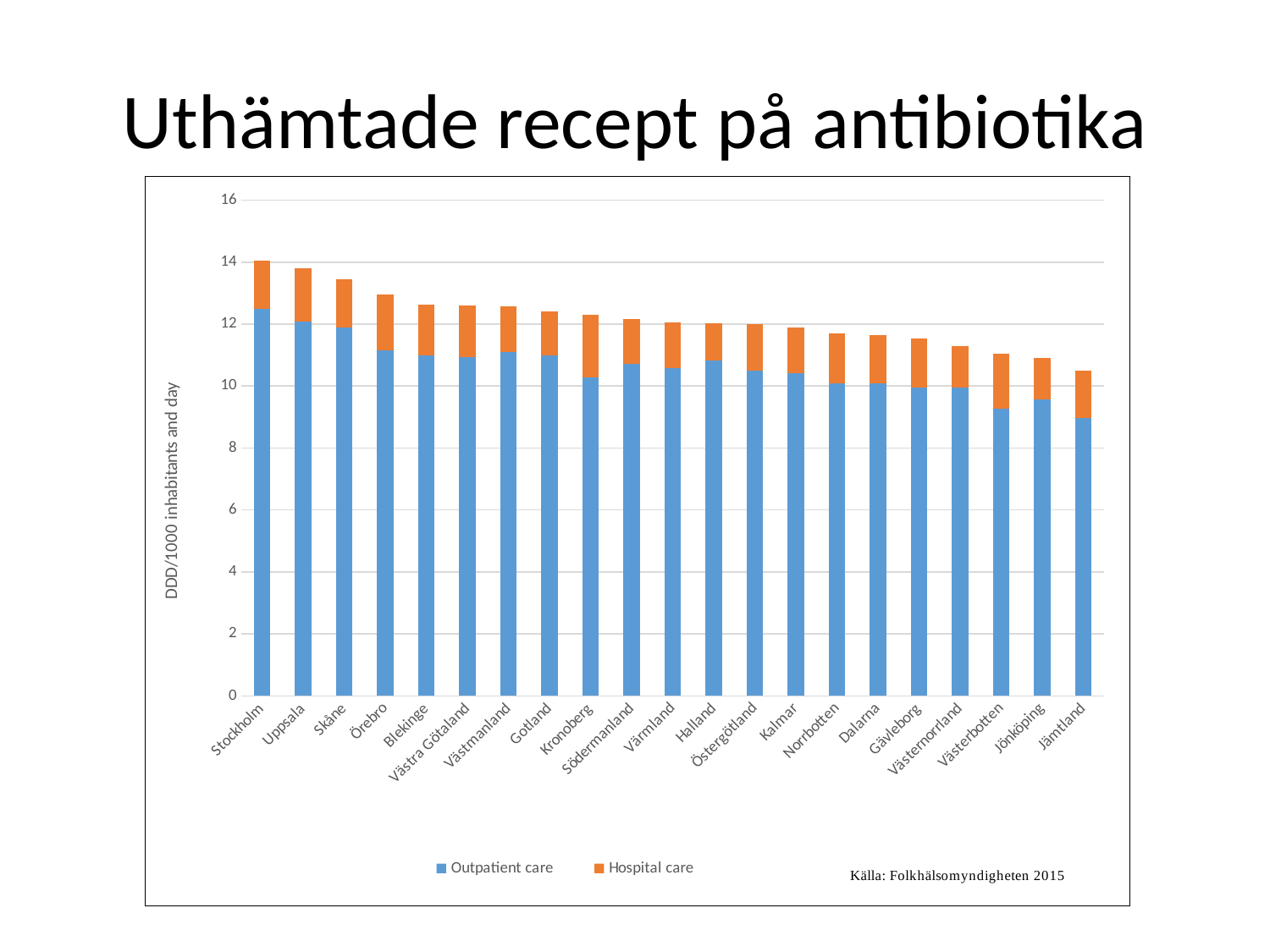
What kind of chart is shown on the slide? Stacked bar chart What is the label on the y axis of the chart? DDD/1000 inhabitants and day Which series is shown in orange in the chart? Hospital care Do the total bar heights rise or fall moving from left to right along the x axis? Fall Which region has the highest total bar in the chart? Stockholm Which region has the lowest total bar in the chart? Jämtland Which has the larger total bar, Örebro or Jönköping? Örebro How many series does the chart's legend list? 2 Is the total value for Jämtland greater or less than 12? less Is the total value for Uppsala greater or less than 12? greater How many regions (categories) are shown on the x axis of the chart? 21 Is the Outpatient care value for Västerbotten greater or less than 10? less